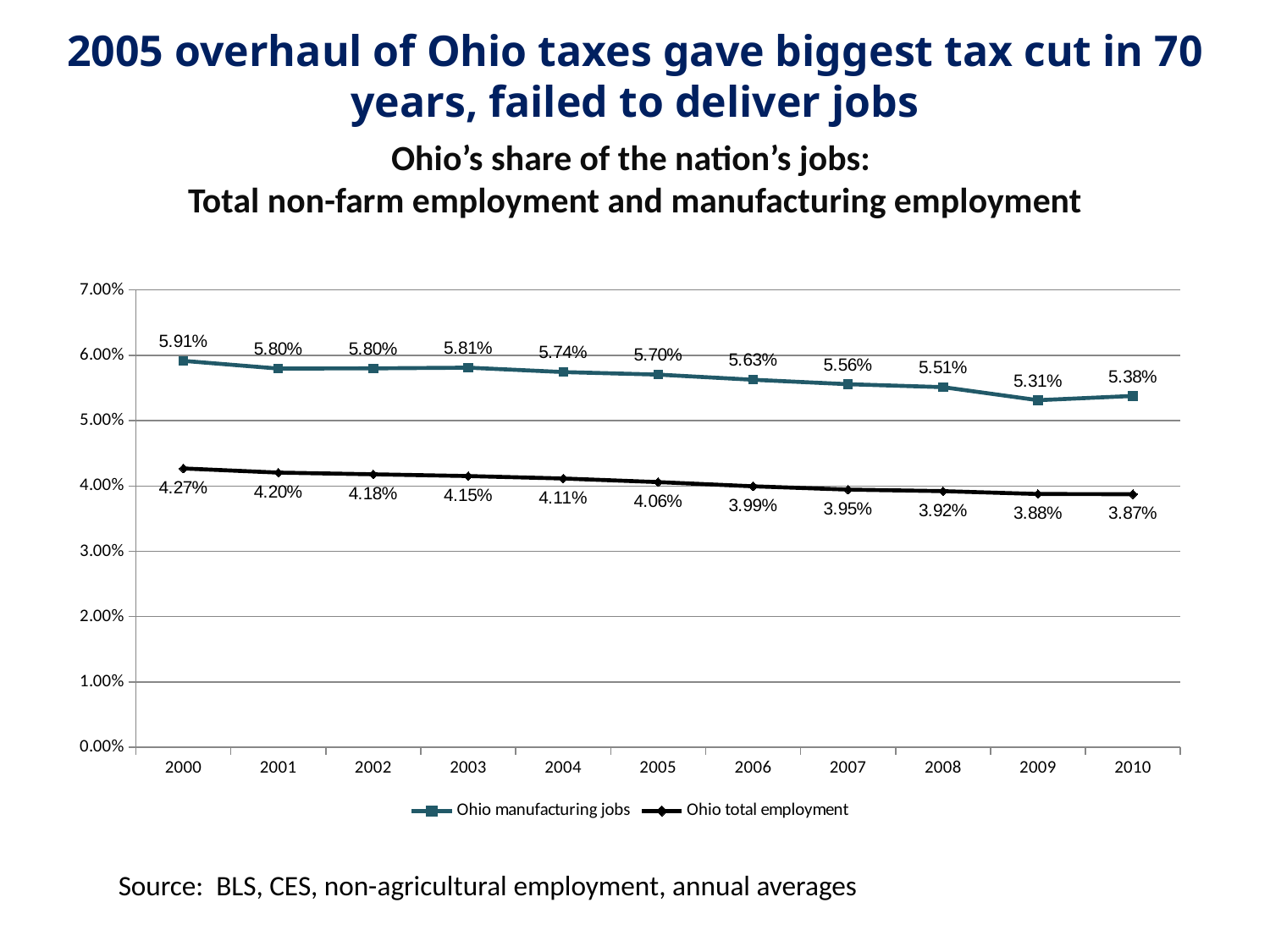
How many years are shown on the x axis? 11 What is the difference between the Ohio manufacturing jobs share and the Ohio total employment share in 2005? 1.64% In which year was the Ohio manufacturing jobs share highest? 2000 What is the difference between the Ohio manufacturing jobs share in 2000 and in 2010? 0.53% How many series does the legend list? 2 What kind of chart is shown on the slide? Line chart What was Ohio's share of the nation's total employment in 2010? 3.87% In which year was the Ohio total employment share lowest? 2010 Does the Ohio total employment share rise or fall from 2000 to 2010? Fall In which year was the Ohio manufacturing jobs share lowest? 2009 Which series has the larger value in 2008, Ohio manufacturing jobs or Ohio total employment? Ohio manufacturing jobs What was Ohio's share of the nation's manufacturing jobs in 2005? 5.70%